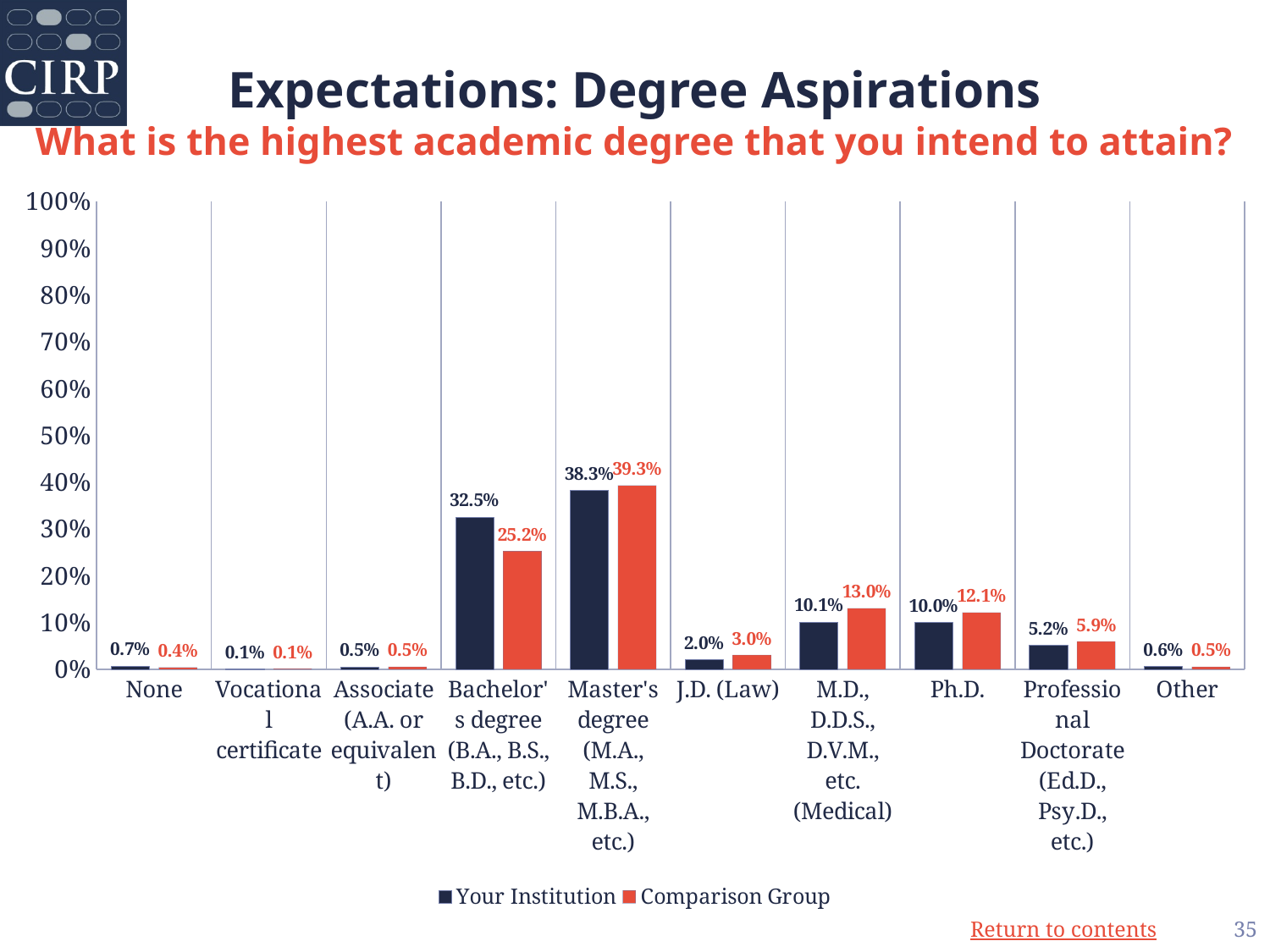
What is the value for the Comparison Group for Master's degree? 39.3% Which is larger for M.D., D.D.S., D.V.M., etc. (Medical): Your Institution or the Comparison Group? Comparison Group How many series does the legend list? 2 How many degree categories are shown on the x axis? 10 Which colour represents the Comparison Group in the chart? Orange-red Which category has the highest value for Your Institution? Master's degree What is the value for Your Institution for Bachelor's degree? 32.5% What kind of chart is shown on the slide? Bar chart What is the difference between the Comparison Group and Your Institution for J.D. (Law)? 1.0% Which category has the lowest value for the Comparison Group? Vocational certificate What is the value for Your Institution for Ph.D.? 10.0% What is the difference between Your Institution and the Comparison Group for Bachelor's degree? 7.3%